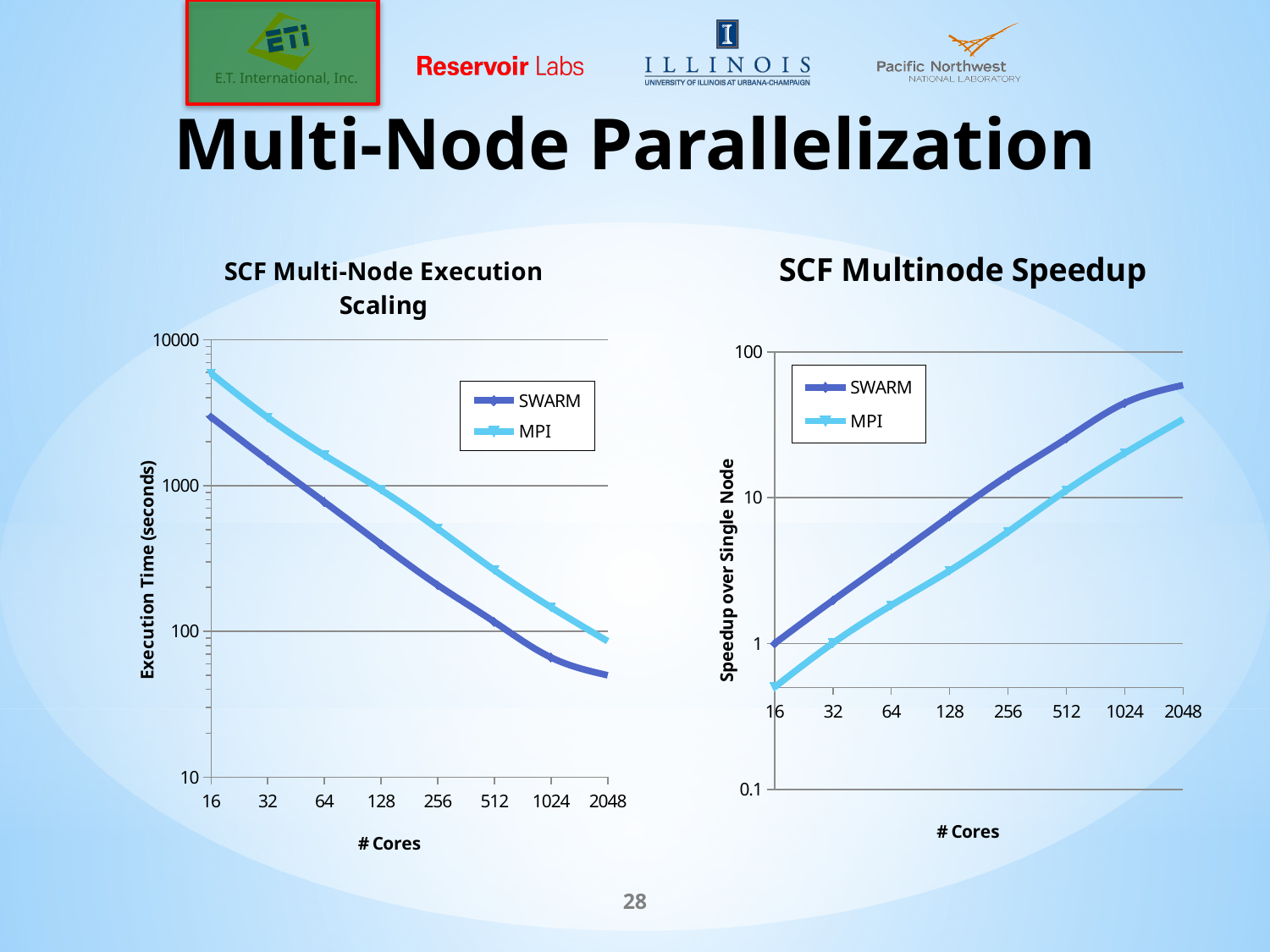
In the "SCF Multi-Node Execution Scaling" chart, does the SWARM execution time rise or fall as the number of cores increases? fall In the "SCF Multinode Speedup" chart, does the MPI speedup rise or fall as the number of cores increases? rise How many series does the legend of the "SCF Multinode Speedup" chart list? 2 How many core counts are plotted along the x axis of the "SCF Multi-Node Execution Scaling" chart? 8 What is the label of the x axis on the "SCF Multi-Node Execution Scaling" chart? # Cores What is the label of the y axis on the "SCF Multinode Speedup" chart? Speedup over Single Node In the "SCF Multinode Speedup" chart, is the MPI speedup at 2048 cores greater or less than 10? greater What kind of chart is the "SCF Multi-Node Execution Scaling" chart? line chart In the "SCF Multinode Speedup" chart, which series has the higher speedup at 2048 cores, SWARM or MPI? SWARM In the "SCF Multi-Node Execution Scaling" chart, is the SWARM execution time at 2048 cores greater or less than 100 seconds? less In the "SCF Multi-Node Execution Scaling" chart, which series has the higher execution time at 128 cores, SWARM or MPI? MPI In the "SCF Multi-Node Execution Scaling" chart, is the SWARM execution time at 16 cores greater or less than 1000 seconds? greater